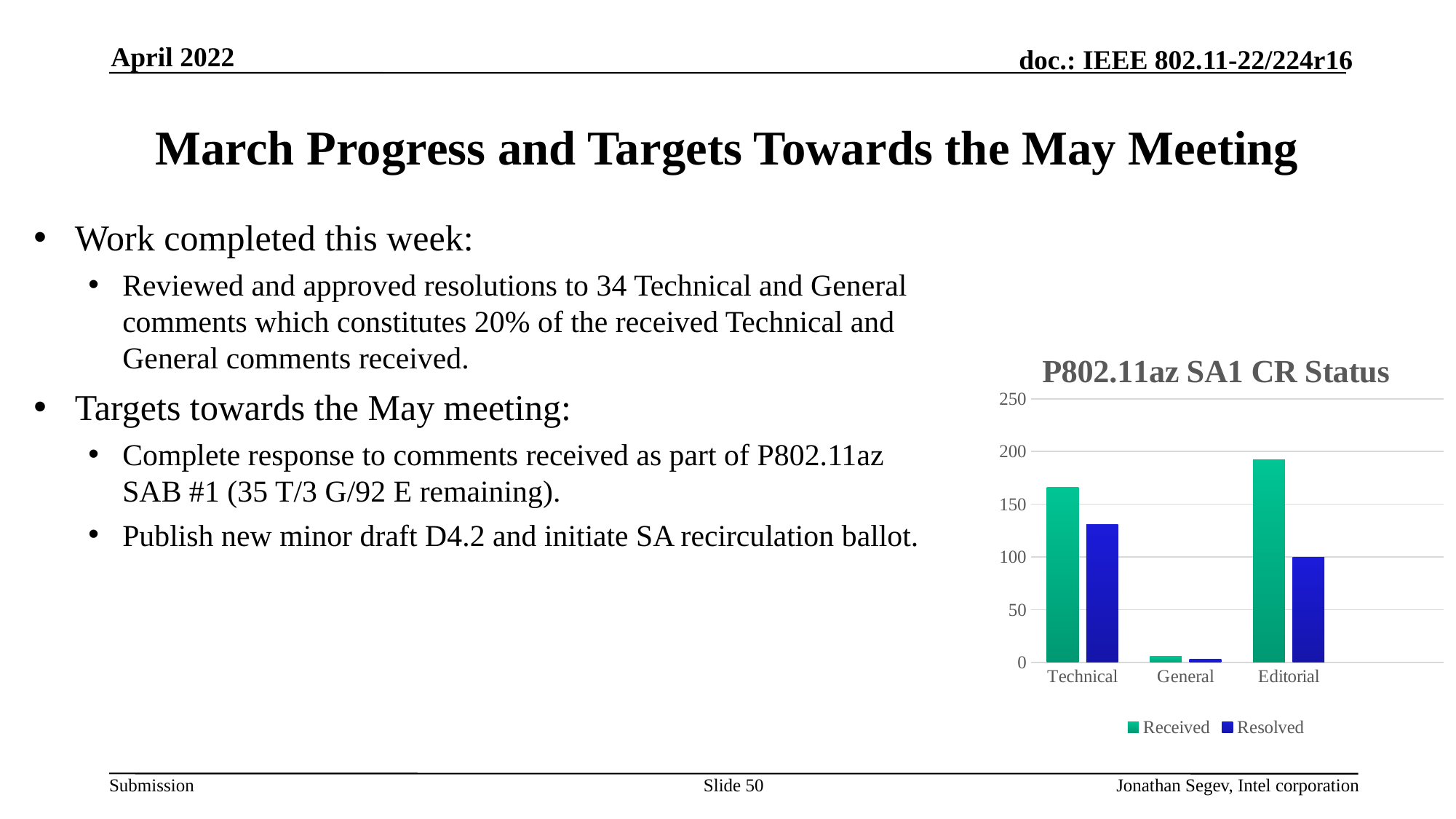
What is the title of the chart? P802.11az SA1 CR Status How many series does the chart legend list? 2 For Technical, which is larger: Received or Resolved? Received Is the Resolved value for Technical greater or less than 100? greater What kind of chart is shown on the slide? bar chart How many categories are shown on the x axis of the chart? 3 Is the Received value for General greater or less than 50? less Which category has the highest Resolved value? Technical Which category has the lowest Received value? General Which series is shown in blue in the chart legend? Resolved Which category has the highest Received value? Editorial Is the Received value for Editorial greater or less than 150? greater